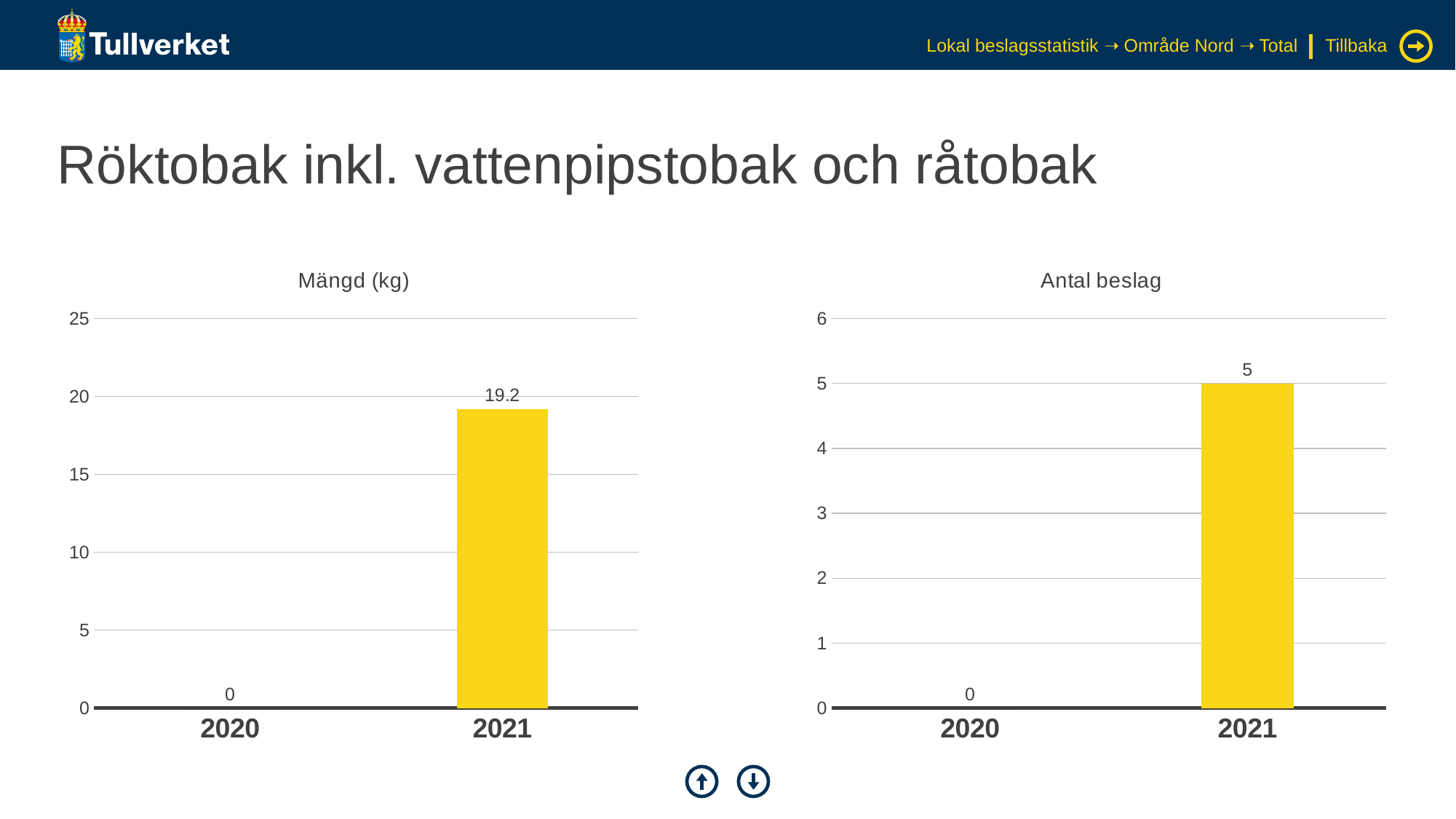
In the 'Mängd (kg)' chart, what is the value for 2021? 19.2 How many years are shown on the x axis of the 'Antal beslag' chart? 2 In the 'Antal beslag' chart, what is the value for 2020? 0 In the 'Antal beslag' chart, what is the value for 2021? 5 In the 'Antal beslag' chart, what is the difference between the 2021 and 2020 values? 5 In the 'Antal beslag' chart, which year has the lowest value? 2020 In the 'Mängd (kg)' chart, what is the value for 2020? 0 In the 'Mängd (kg)' chart, is the value for 2021 greater or less than 15? greater In the 'Mängd (kg)' chart, what is the difference between the 2021 and 2020 values? 19.2 What kind of chart is the 'Mängd (kg)' chart? bar chart In the 'Antal beslag' chart, do the values rise or fall from 2020 to 2021? rise In the 'Mängd (kg)' chart, which year has the highest value? 2021